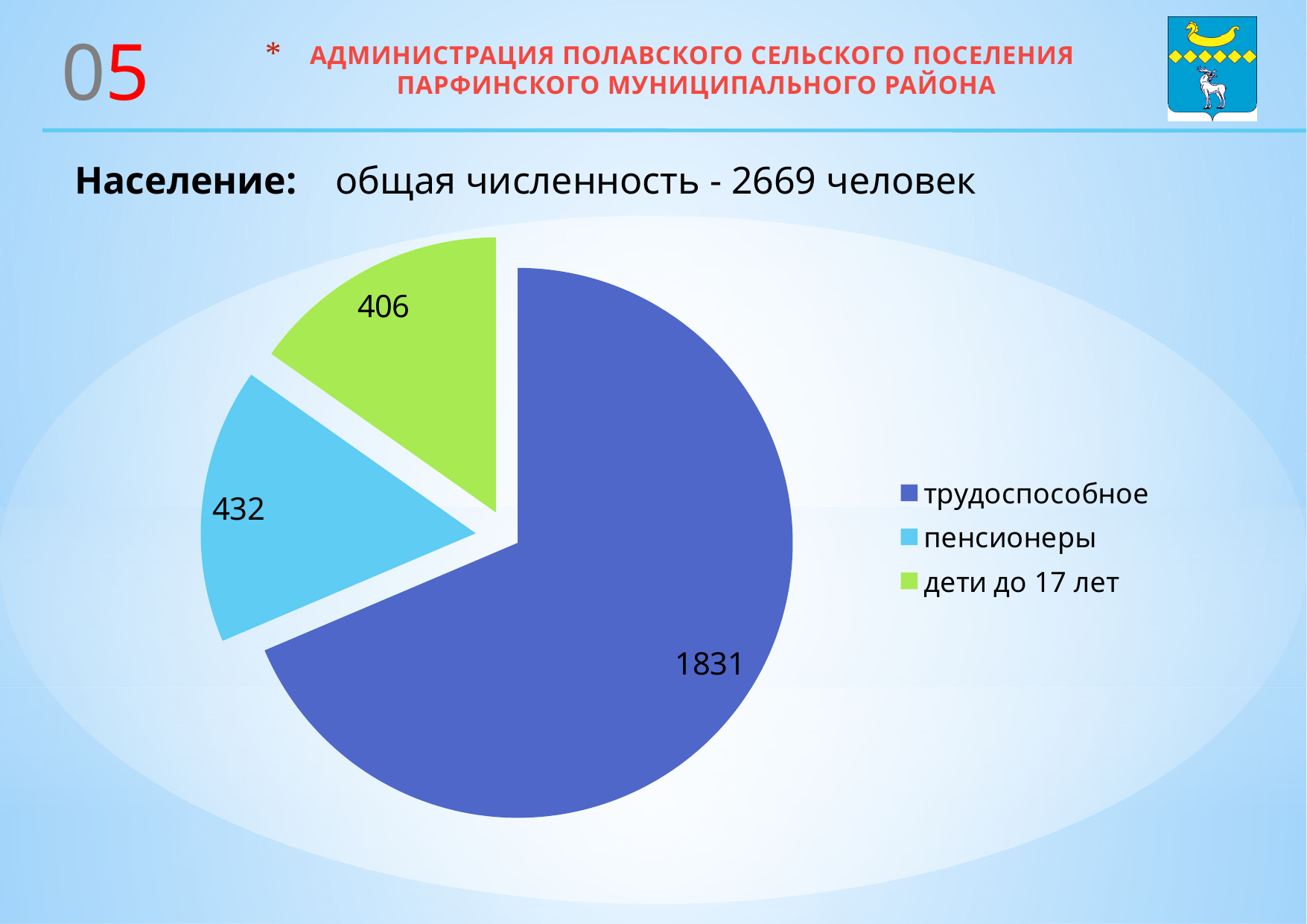
What is the value for пенсионеры? 432 What kind of chart is shown on the slide? pie chart What colour is the slice for дети до 17 лет? green Which category has the largest slice of the pie? трудоспособное What is the difference between the values for пенсионеры and дети до 17 лет? 26 What is the difference between the values for трудоспособное and пенсионеры? 1399 Which is larger, the value for пенсионеры or the value for дети до 17 лет? пенсионеры Which category has the smallest value? дети до 17 лет How many categories does the pie chart have? 3 What share of the total population does трудоспособное represent? 68.6% What is the value for дети до 17 лет? 406 What is the value for трудоспособное? 1831